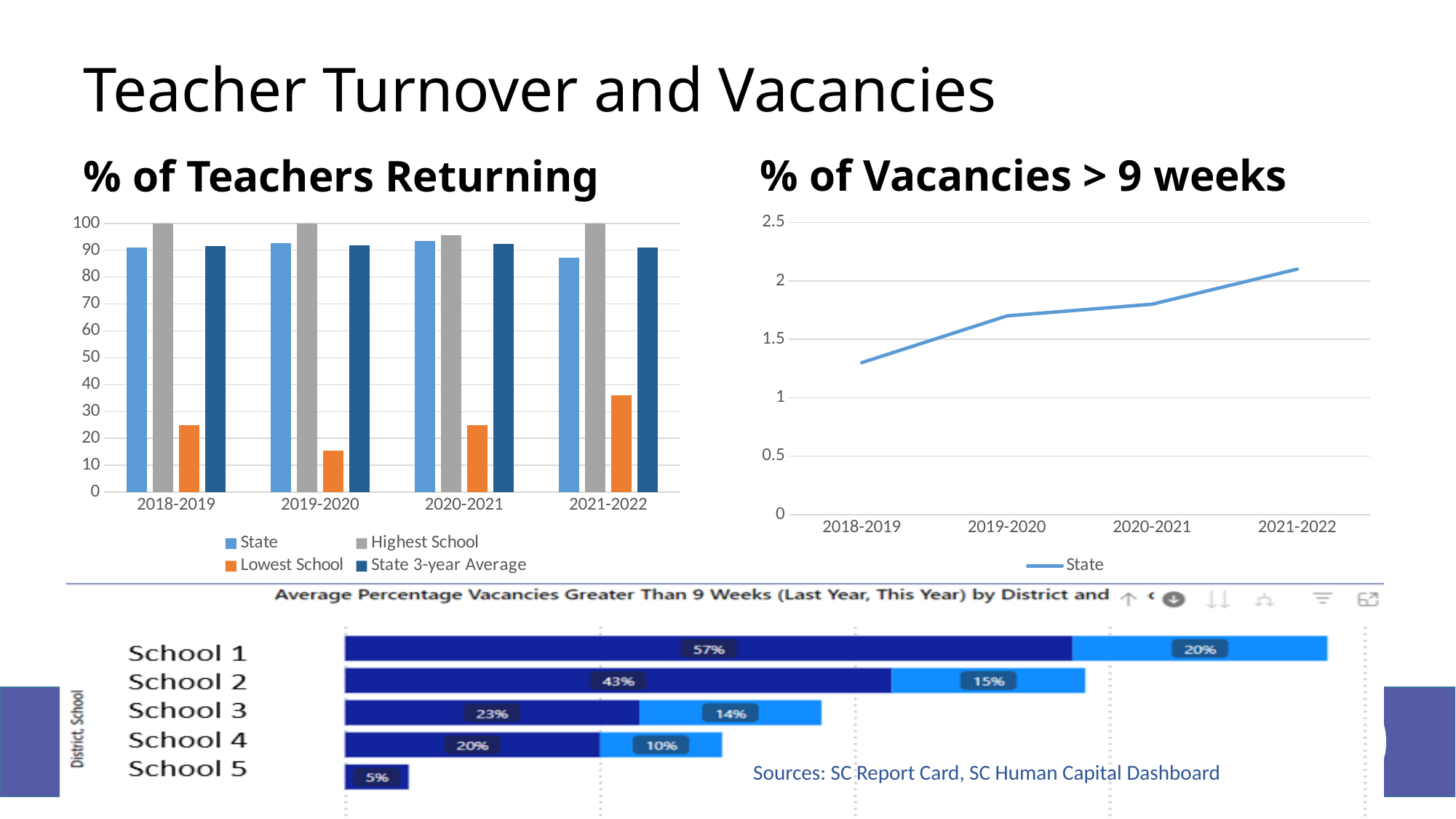
In the '% of Teachers Returning' chart, which year has the lowest Lowest School value? 2019-2020 In the '% of Vacancies > 9 weeks' chart, do the State values rise or fall from 2018-2019 to 2021-2022? rise In the '% of Teachers Returning' chart, is the Lowest School value for 2021-2022 greater or less than 30? greater What kind of chart is the '% of Vacancies > 9 weeks' chart? line chart In the bottom chart of vacancies greater than 9 weeks by school, what is the total of the two segments for School 2? 58% In the '% of Teachers Returning' chart, is the Lowest School value for 2019-2020 greater or less than 20? less What kind of chart is the '% of Teachers Returning' chart? bar chart How many series does the legend of the '% of Teachers Returning' chart list? 4 In the bottom chart of vacancies greater than 9 weeks by school, what is the value of the light blue segment for School 3? 14% How many schools are shown in the bottom chart of vacancies greater than 9 weeks? 5 In the bottom chart of vacancies greater than 9 weeks by school, what is the value of the dark blue segment for School 1? 57% In the '% of Vacancies > 9 weeks' chart, is the State value for 2018-2019 greater or less than 1.5? less